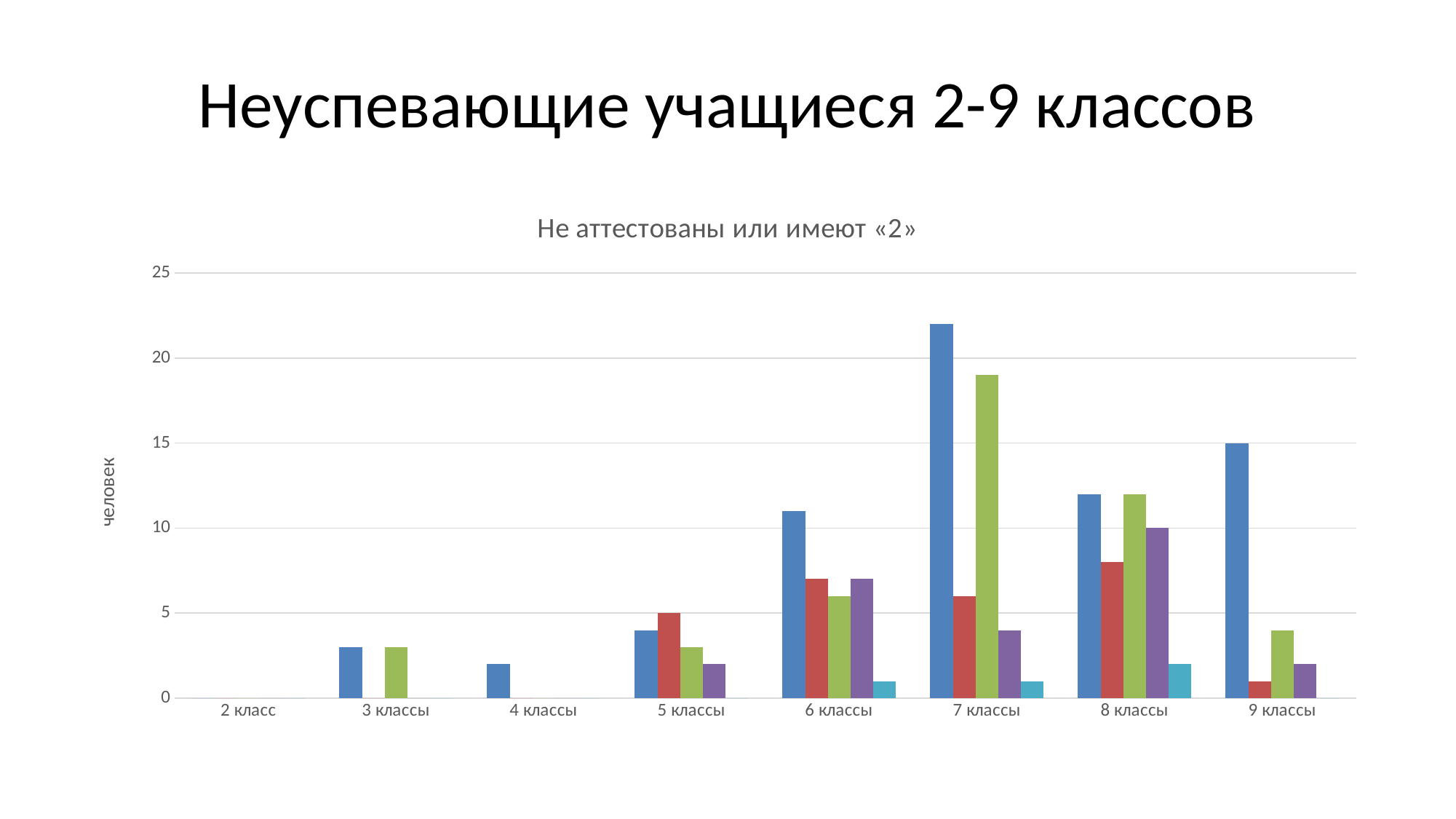
Is the value of the blue bar for 6 классы greater or less than 15? less Which category contains the tallest bar in the chart? 7 классы In the 7 классы group, which is larger: the green bar or the red bar? green What is the label on the vertical axis? человек How many class categories are shown on the x axis? 8 Is the value of the blue bar for 7 классы greater or less than 20? greater What is the title of the chart? Не аттестованы или имеют «2» Is the value of the blue bar for 4 классы greater or less than 5? less What kind of chart is shown on the slide? bar chart Which is larger: the blue bar for 7 классы or the blue bar for 9 классы? 7 классы Which category has no bars at all? 2 класс